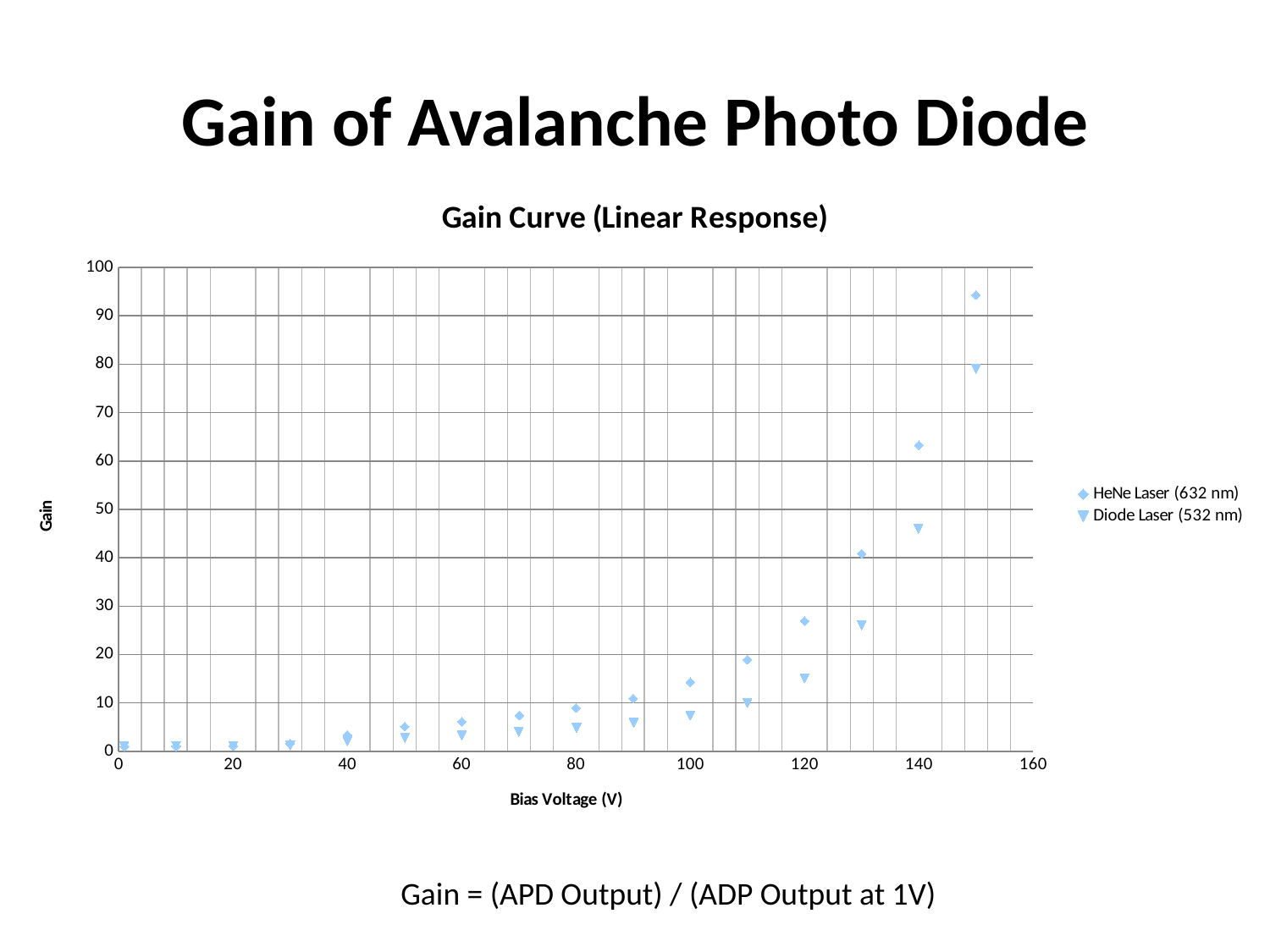
Is the gain for HeNe Laser (632 nm) at 140 V greater or less than 60? greater Does the gain for HeNe Laser (632 nm) rise or fall as bias voltage increases? Rise Is the gain for Diode Laser (532 nm) at 140 V greater or less than 50? less How many series does the legend list? 2 Is the gain for Diode Laser (532 nm) at 150 V greater or less than 70? greater What kind of chart is shown on the slide? Scatter chart What is the label of the x axis? Bias Voltage (V) At 150 V, which series has the higher gain, HeNe Laser (632 nm) or Diode Laser (532 nm)? HeNe Laser (632 nm) What is the title of the chart? Gain Curve (Linear Response)